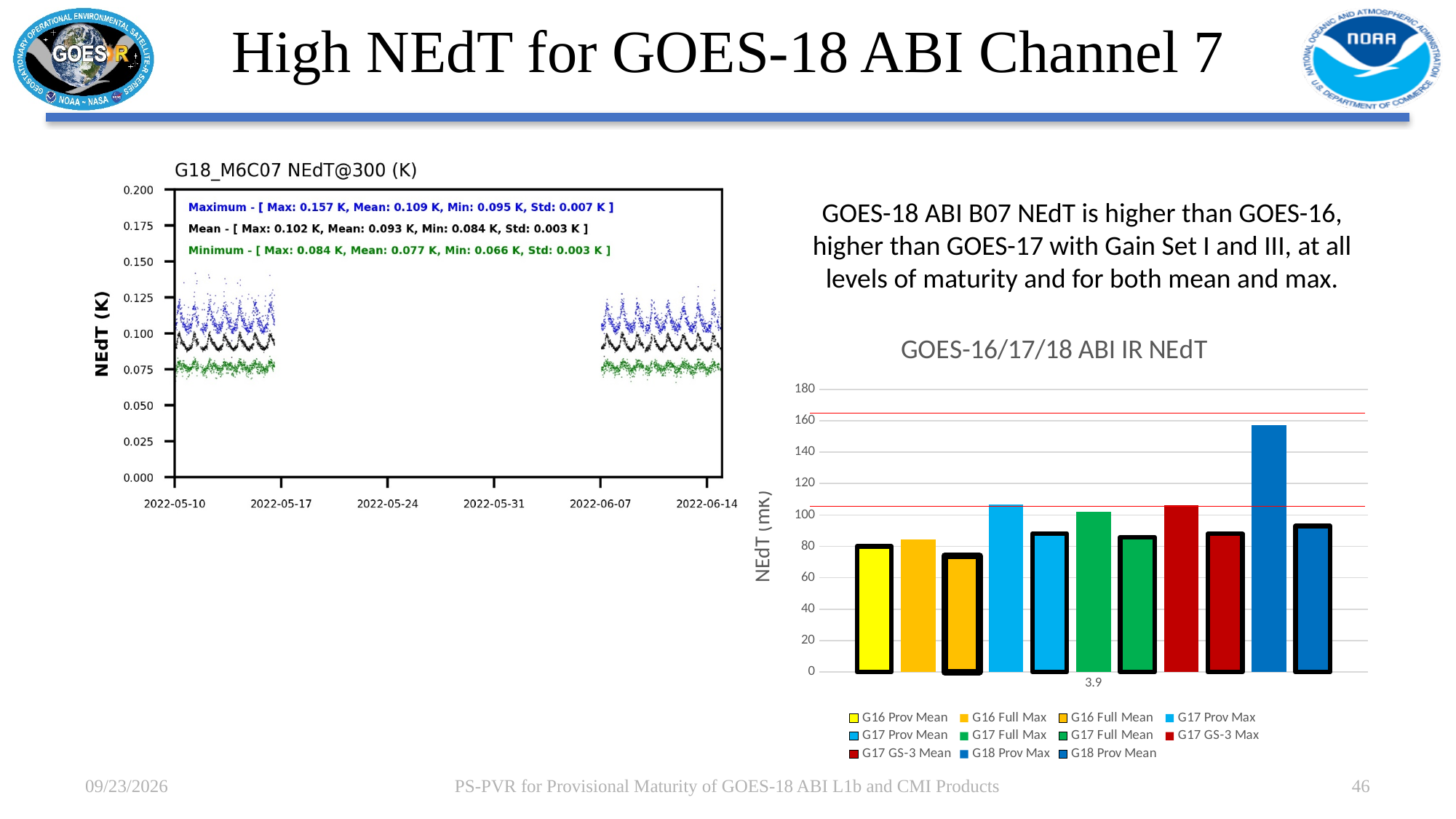
On the G18_M6C07 NEdT@300 (K) chart, what is the Min value listed for the Minimum series? 0.066 K On the GOES-16/17/18 ABI IR NEdT chart, is the value for G17 Prov Max greater or less than 100? greater On the GOES-16/17/18 ABI IR NEdT chart, which is larger, G18 Prov Max or G17 Prov Max? G18 Prov Max On the GOES-16/17/18 ABI IR NEdT chart, what is the y-axis label? NEdT (mK) On the GOES-16/17/18 ABI IR NEdT chart, which series has the highest bar? G18 Prov Max On the GOES-16/17/18 ABI IR NEdT chart, is the value for G16 Prov Mean greater or less than 100? less What kind of chart is the GOES-16/17/18 ABI IR NEdT chart? bar chart On the GOES-16/17/18 ABI IR NEdT chart, is the value for G18 Prov Max greater or less than 140? greater On the G18_M6C07 NEdT@300 (K) chart, what is the Mean value listed for the Mean series? 0.093 K On the G18_M6C07 NEdT@300 (K) chart, what is the Max value listed for the Maximum series? 0.157 K On the GOES-16/17/18 ABI IR NEdT chart, how many series does the legend list? 11 On the G18_M6C07 NEdT@300 (K) chart, what is the Std value listed for the Maximum series? 0.007 K